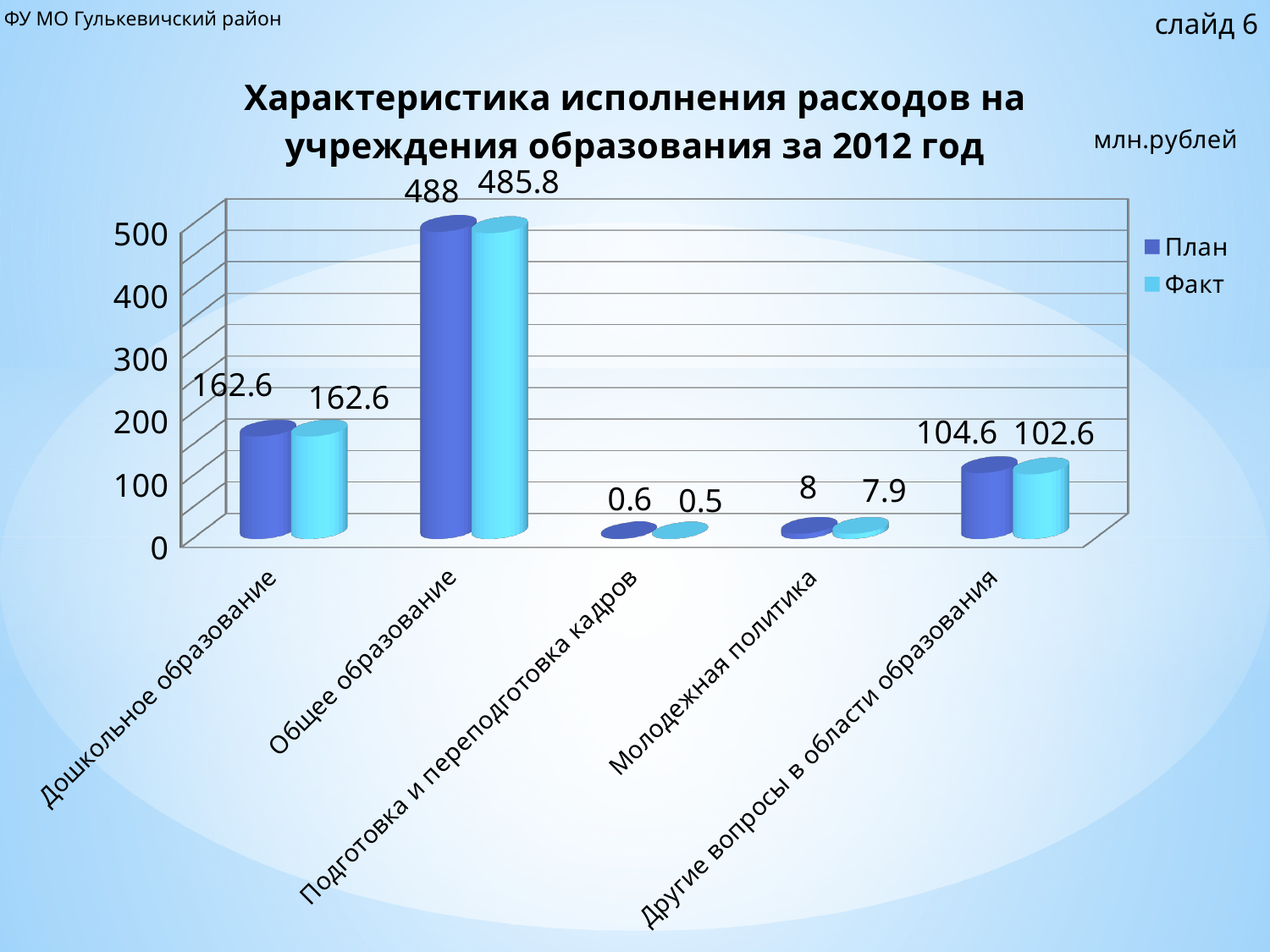
What kind of chart is shown on the slide? Bar chart What is the План value for Общее образование? 488 Which is larger for Дошкольное образование: the План value or the Факт value? They are equal (162.6) Which category has the highest План value? Общее образование How many series does the legend list? 2 What unit is indicated for the values on the chart? млн.рублей What is the Факт value for Молодежная политика? 7.9 What is the difference between the План and Факт values for Общее образование? 2.2 What is the Факт value for Другие вопросы в области образования? 102.6 Which category has the lowest Факт value? Подготовка и переподготовка кадров What is the difference between the План and Факт values for Другие вопросы в области образования? 2 How many categories are shown on the x axis? 5